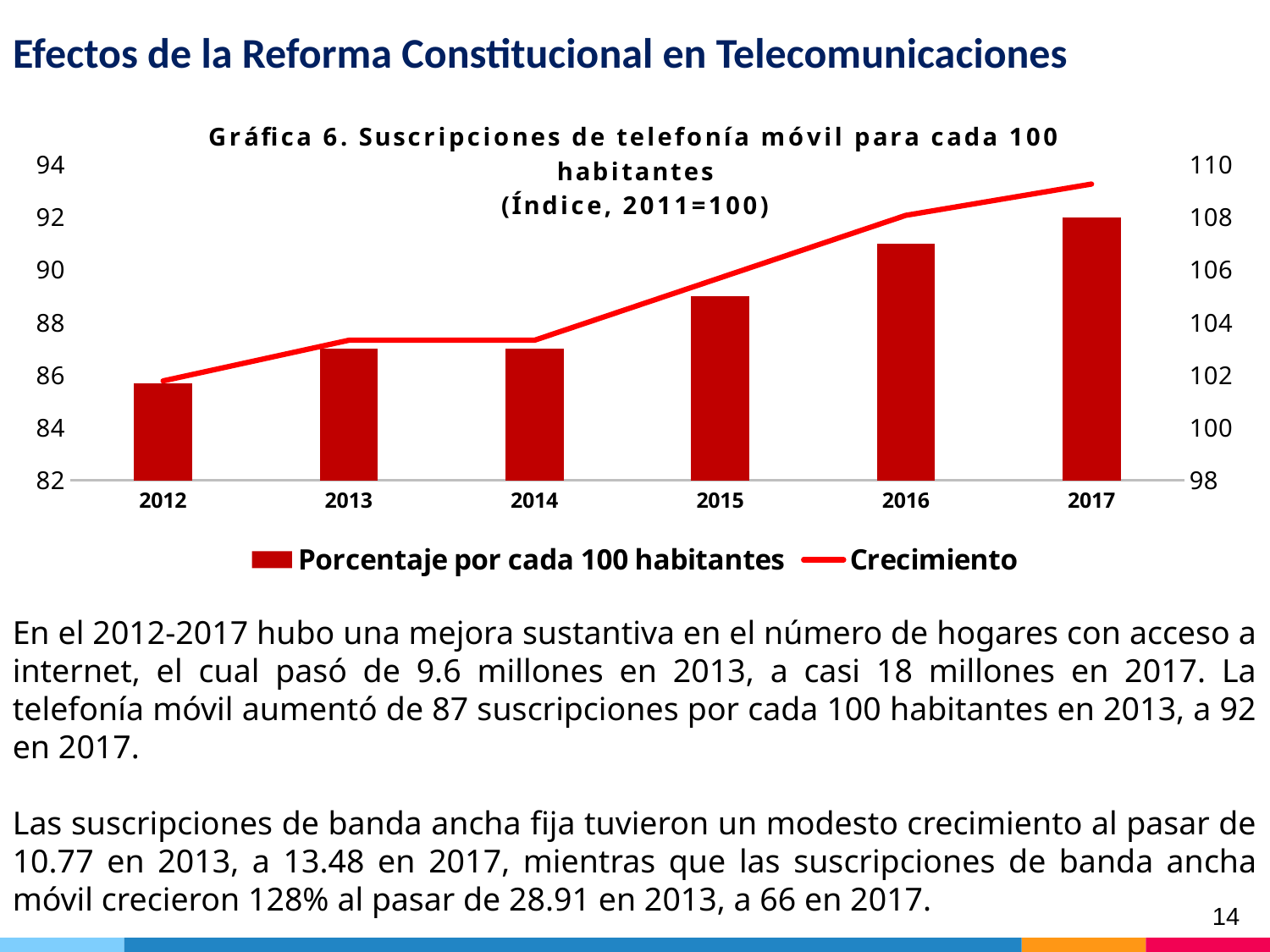
Is the 'Crecimiento' value for 2017 greater or less than 108 on the right axis? greater Which year has the lowest bar for 'Porcentaje por cada 100 habitantes'? 2012 Which year has a larger bar, 2012 or 2017? 2017 How many series does the legend list? 2 Which series is drawn as a red line in the chart? Crecimiento Does the 'Crecimiento' line rise or fall from 2012 to 2017? Rises Which year has the highest bar for 'Porcentaje por cada 100 habitantes'? 2017 How many years are shown on the x axis of the chart? 6 Is the bar value for 2016 greater or less than 90? greater What is the title of the chart? Gráfica 6. Suscripciones de telefonía móvil para cada 100 habitantes (Índice, 2011=100) What kind of chart is Gráfica 6? A combined bar and line chart Is the bar value for 2015 greater or less than 88? greater